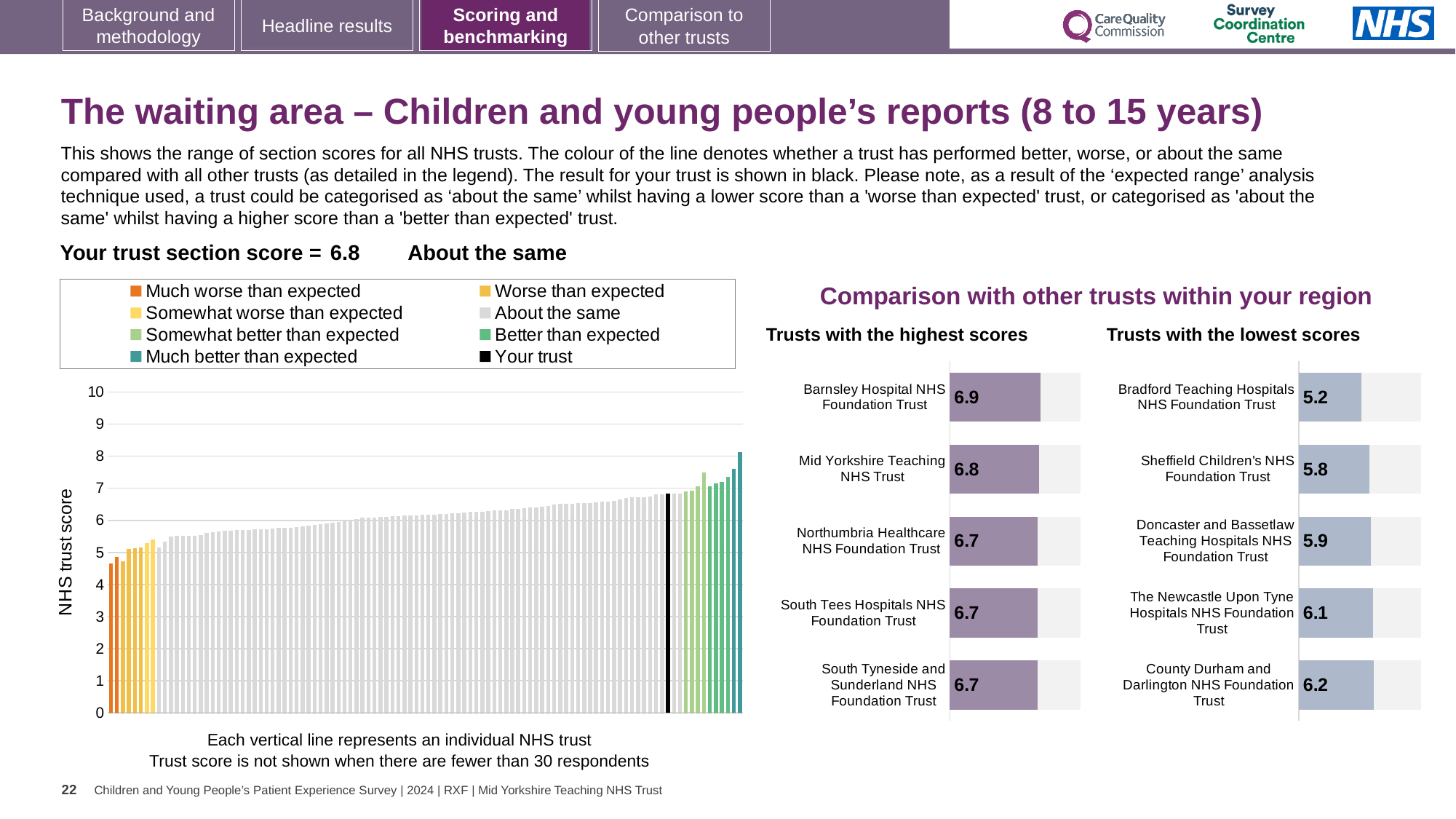
How many trusts are shown in the 'Trusts with the lowest scores' chart? 5 In the 'Trusts with the lowest scores' chart, which trust has the lowest score? Bradford Teaching Hospitals NHS Foundation Trust In the 'Trusts with the lowest scores' chart, what is the score for Bradford Teaching Hospitals NHS Foundation Trust? 5.2 In the 'Trusts with the highest scores' chart, what is the score for Barnsley Hospital NHS Foundation Trust? 6.9 In the large chart on the left, do the trust scores rise or fall from left to right along the x axis? rise What is the difference between the score for Barnsley Hospital NHS Foundation Trust in the 'highest scores' chart and the score for Bradford Teaching Hospitals NHS Foundation Trust in the 'lowest scores' chart? 1.7 In the large chart on the left, is the value for the black 'Your trust' bar greater or less than 6? greater In the 'Trusts with the highest scores' chart, what is the score for Mid Yorkshire Teaching NHS Trust? 6.8 In the 'Trusts with the lowest scores' chart, what is the difference between the scores for County Durham and Darlington NHS Foundation Trust and Sheffield Children's NHS Foundation Trust? 0.4 In the 'Trusts with the highest scores' chart, which trust has the highest score? Barnsley Hospital NHS Foundation Trust In the 'Trusts with the lowest scores' chart, what is the score for The Newcastle Upon Tyne Hospitals NHS Foundation Trust? 6.1 How many entries does the legend of the large chart on the left list? 8